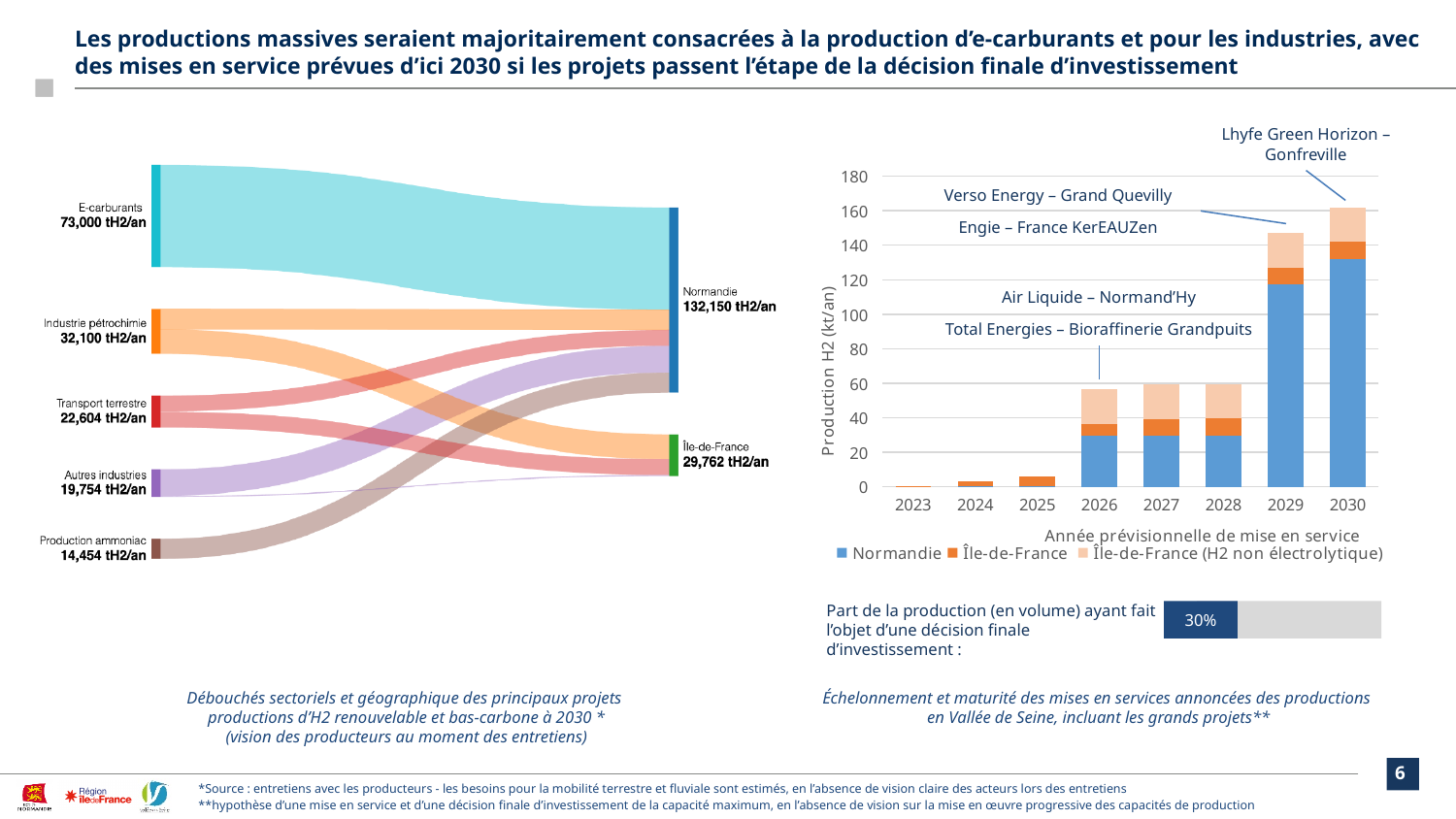
On the left chart, what is the value for Production ammoniac? 14,454 tH2/an On the right chart, how many series does the legend list? 3 On the left chart, what is the value for Île-de-France? 29,762 tH2/an On the right chart, is the total value for 2030 greater or less than 140? greater On the right chart, what kind of chart is it? Stacked bar chart On the left chart, which sector on the left side has the highest value? E-carburants On the left chart, what is the value for Normandie? 132,150 tH2/an On the left chart, what is the value for E-carburants? 73,000 tH2/an On the left chart, which sector on the left side has the lowest value? Production ammoniac On the left chart, what is the difference between Industrie pétrochimie and Transport terrestre? 9,496 tH2/an On the left chart, which is larger: Autres industries or Production ammoniac? Autres industries On the right chart, how many years are shown on the x axis? 8